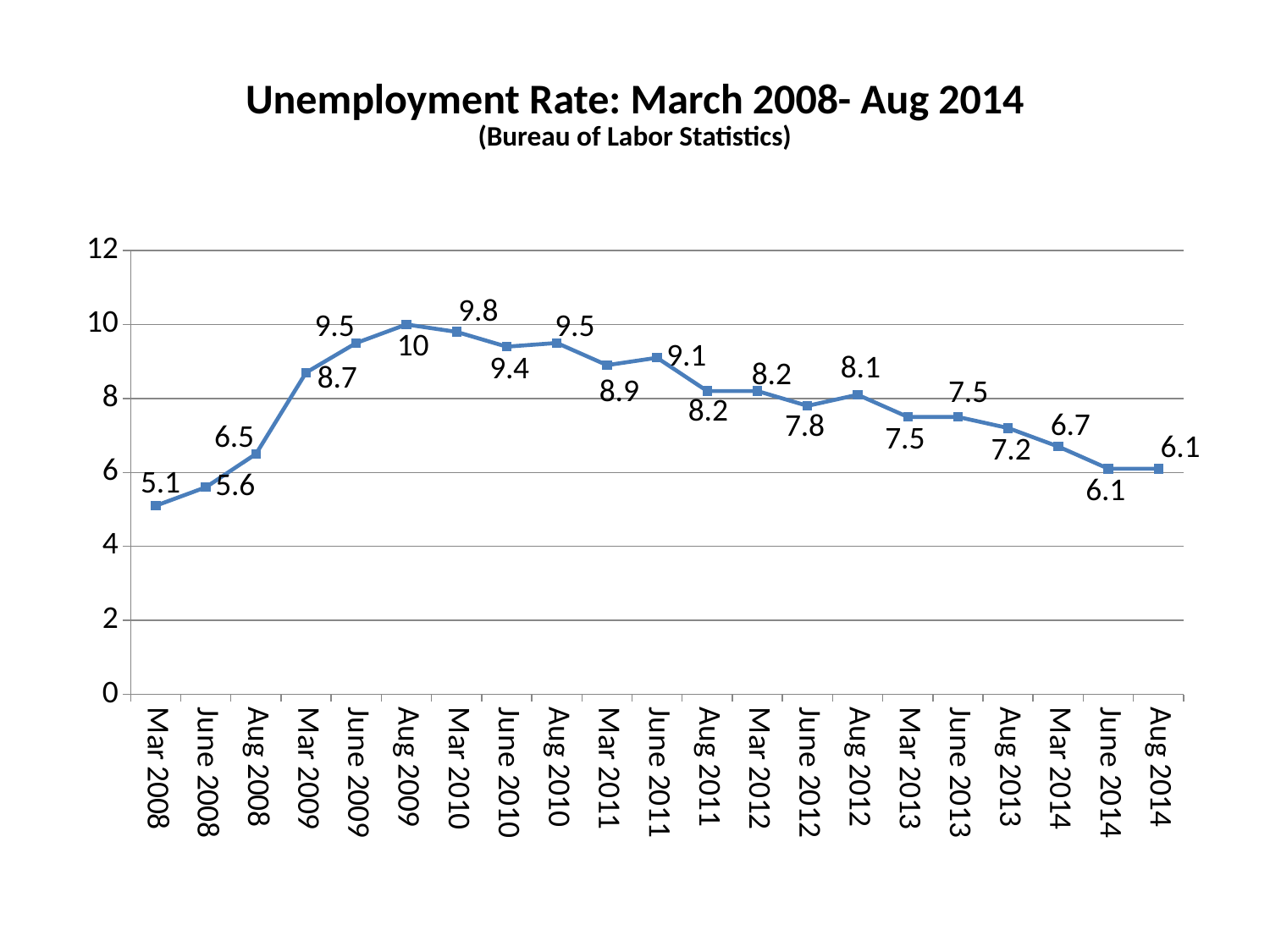
What type of chart is shown on the slide? line chart What is the title of the chart? Unemployment Rate: March 2008- Aug 2014 Which is higher, the unemployment rate in Mar 2010 or Mar 2013? Mar 2010 Which period has the highest unemployment rate? Aug 2009 How many data points are plotted on the chart? 21 Which period has the lowest unemployment rate? Mar 2008 What is the unemployment rate for Mar 2008? 5.1 What is the difference between the unemployment rate in Aug 2009 and Aug 2014? 3.9 Does the unemployment rate rise or fall from Aug 2009 to Aug 2014? fall What is the unemployment rate for June 2012? 7.8 What is the unemployment rate for Aug 2014? 6.1 What is the unemployment rate for Aug 2009? 10